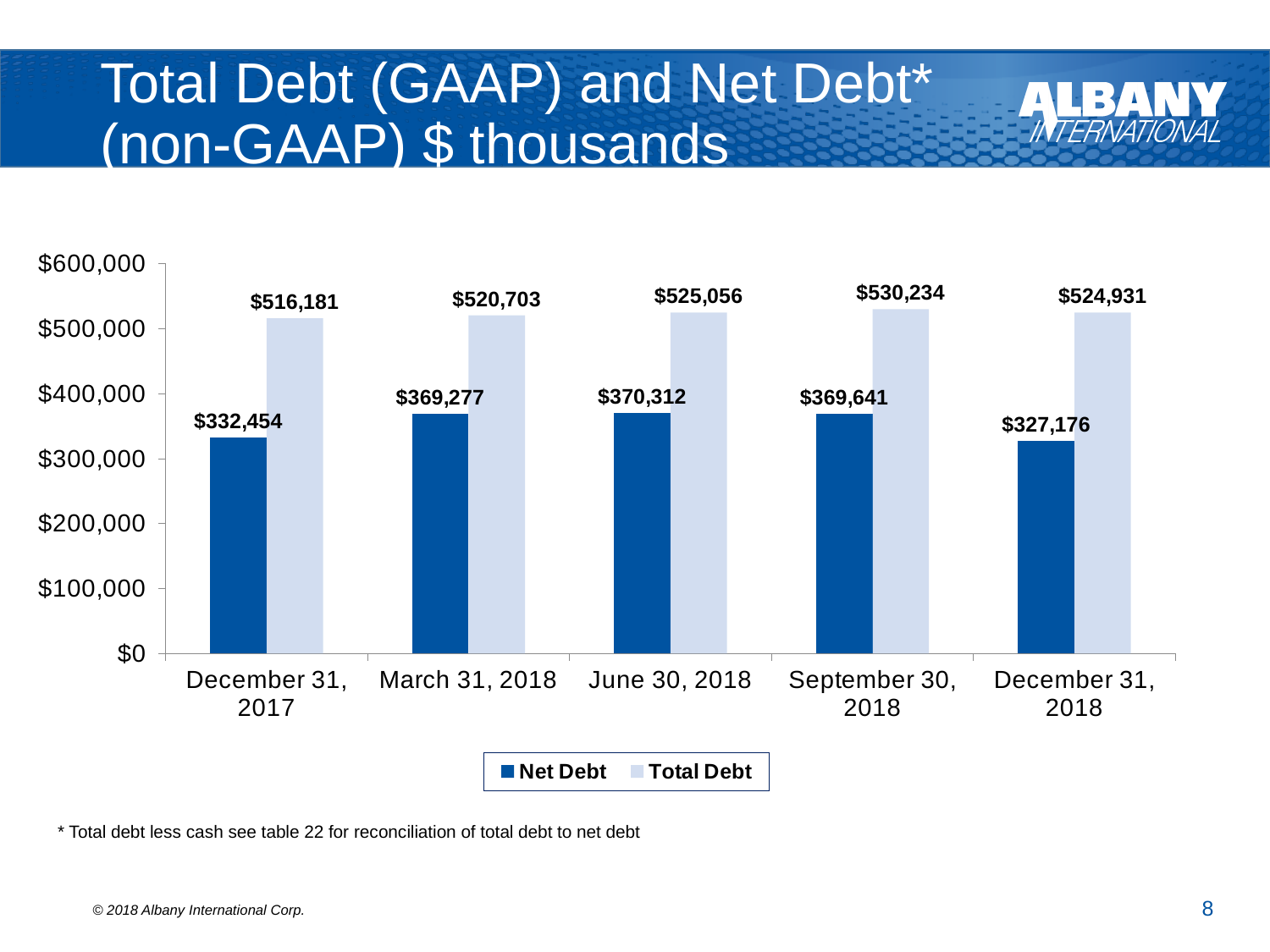
Is the Net Debt value for March 31, 2018 greater or less than $400,000? less How many dates are shown on the x axis? 5 How many series does the legend list? 2 What is the difference between Total Debt and Net Debt on December 31, 2017? $183,727 Which is larger on June 30, 2018, Net Debt or Total Debt? Total Debt What is the Net Debt value for December 31, 2017? $332,454 What is the Net Debt value for June 30, 2018? $370,312 What is the Total Debt value for September 30, 2018? $530,234 On which date is Total Debt highest? September 30, 2018 What kind of chart is shown on the slide? bar chart What is the Total Debt value for March 31, 2018? $520,703 What is the difference between Total Debt and Net Debt on December 31, 2018? $197,755